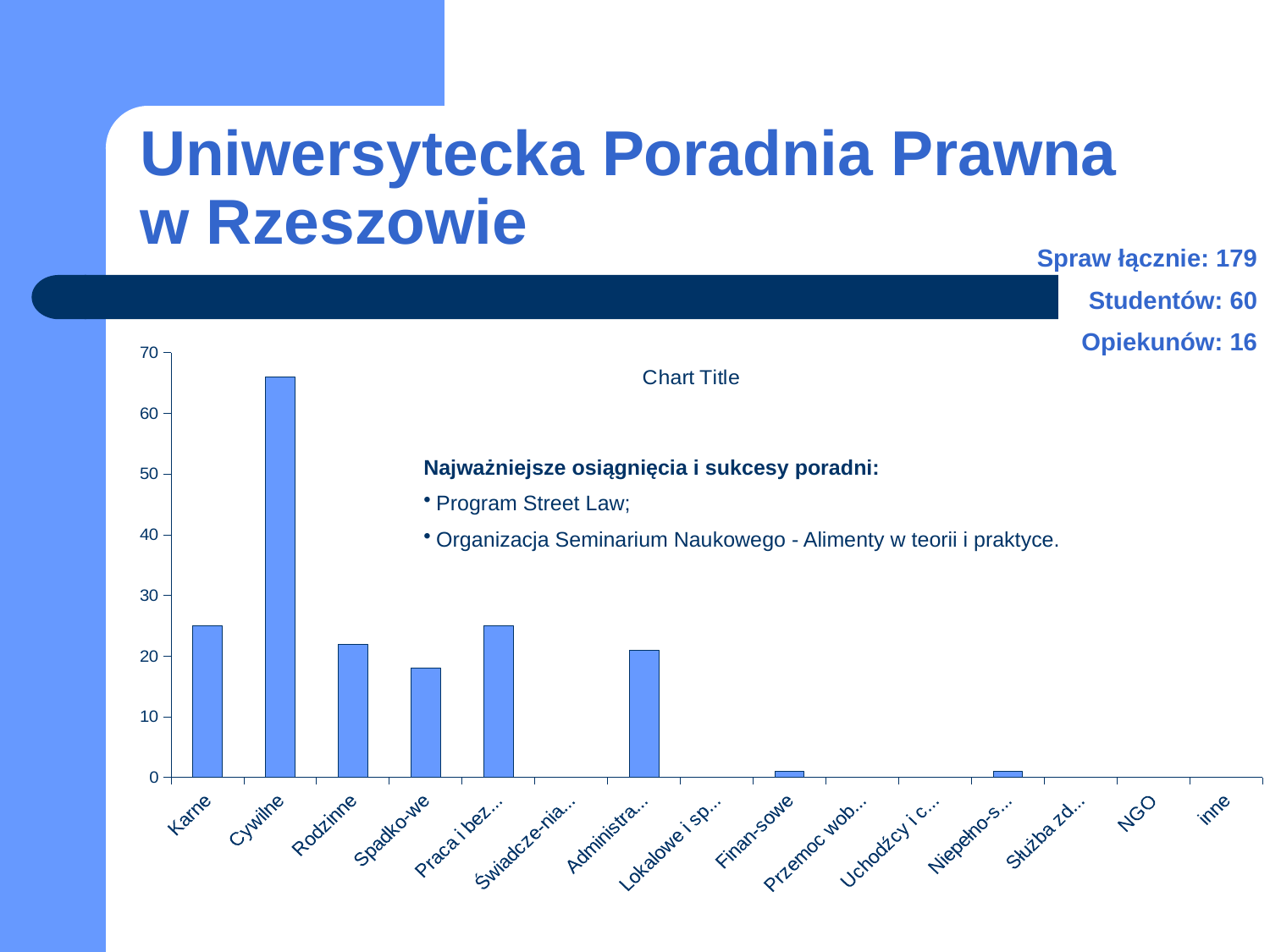
Is the value for Spadko-we greater or less than 20? less How many categories are shown on the x axis of the chart? 15 Is the value for Karne greater or less than 20? greater What is the highest value shown on the chart's vertical axis? 70 Which is larger, the value for Karne or the value for Spadko-we? Karne What is the title shown on the chart? Chart Title Is the value for Finan-sowe greater or less than 10? less Which is larger, the value for Cywilne or the value for Karne? Cywilne What kind of chart is shown on the slide? bar chart Which category has the highest bar in the chart? Cywilne